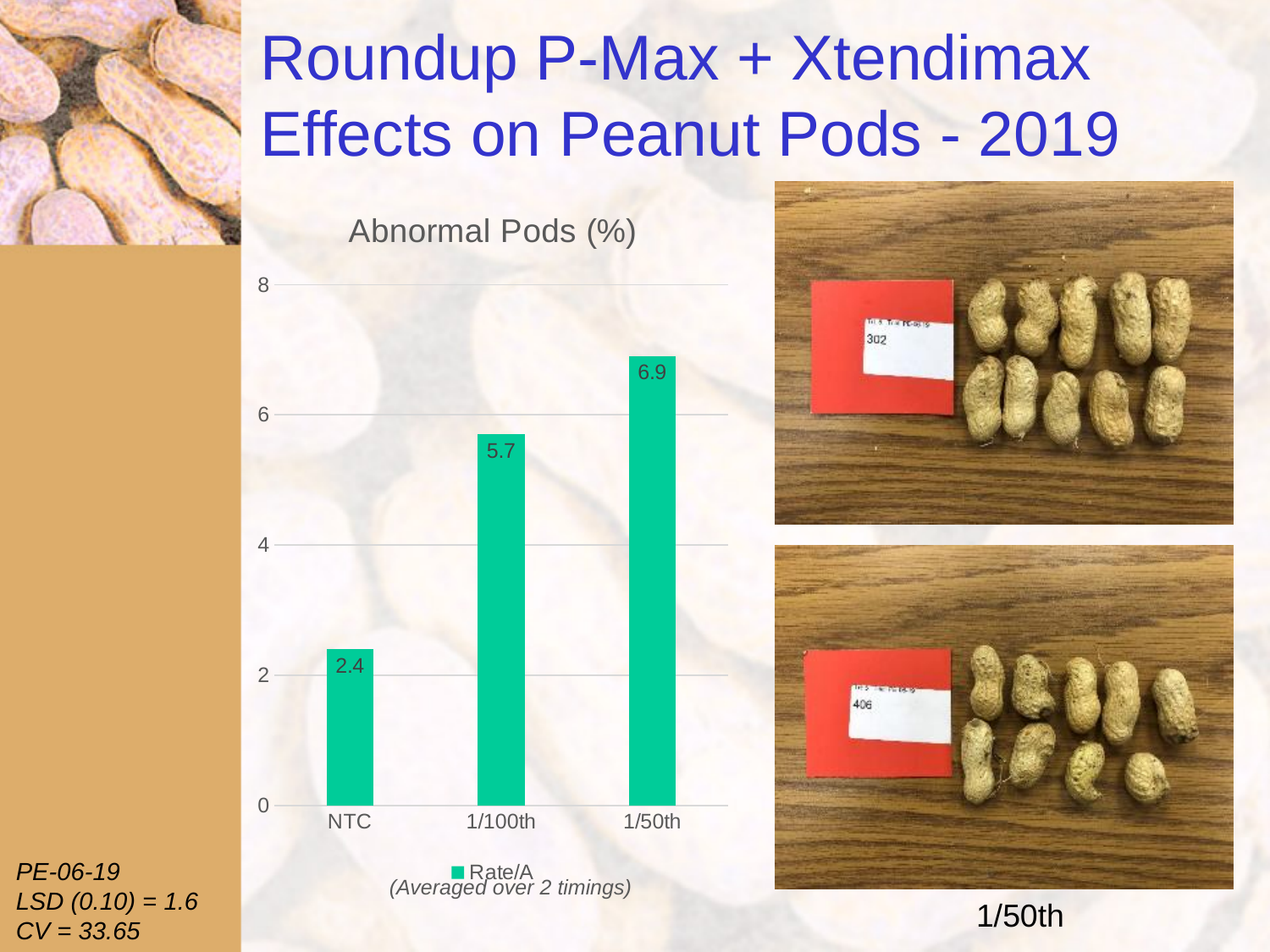
What is the difference between the values for 1/50th and NTC in the Abnormal Pods (%) chart? 4.5 Do the values rise or fall from NTC to 1/50th in the Abnormal Pods (%) chart? rise What kind of chart is the Abnormal Pods (%) chart? bar chart Which category has the lowest value in the Abnormal Pods (%) chart? NTC What is the value for NTC in the Abnormal Pods (%) chart? 2.4 What is the value for 1/50th in the Abnormal Pods (%) chart? 6.9 How many categories are shown on the x axis of the Abnormal Pods (%) chart? 3 What is the value for 1/100th in the Abnormal Pods (%) chart? 5.7 Which is larger in the Abnormal Pods (%) chart, the value for 1/100th or the value for NTC? 1/100th Is the value for 1/100th greater or less than 4 in the Abnormal Pods (%) chart? greater Which category has the highest value in the Abnormal Pods (%) chart? 1/50th What is the difference between the values for 1/50th and 1/100th in the Abnormal Pods (%) chart? 1.2